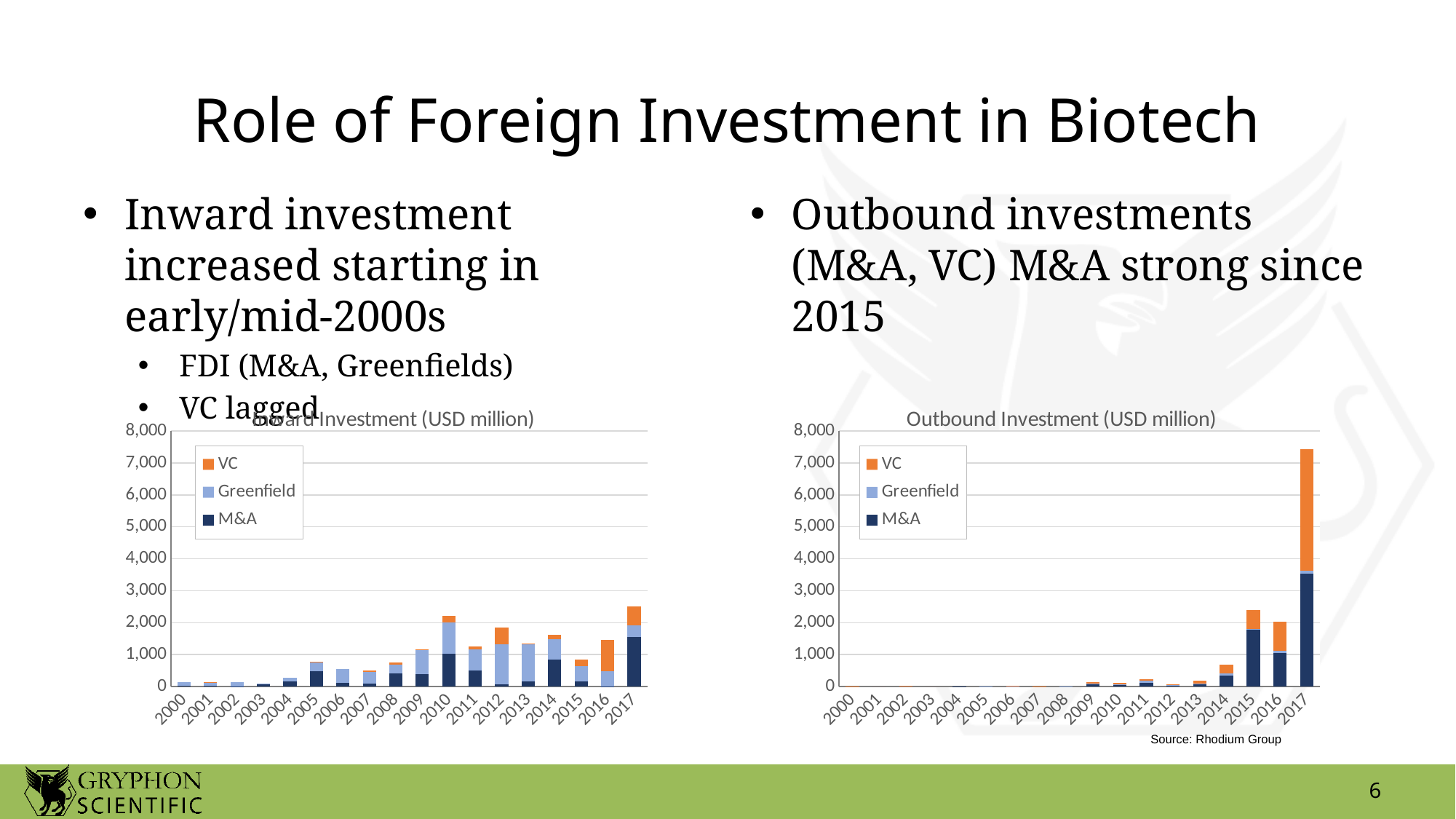
In the Inward Investment (USD million) chart, is the total value for 2005 greater or less than 1,000? less What kind of chart is the Inward Investment (USD million) chart? Stacked bar chart In the Inward Investment (USD million) chart, is the total value for 2017 greater or less than 2,000? greater In the Outbound Investment (USD million) chart, which year has the larger total bar, 2015 or 2017? 2017 In the Outbound Investment (USD million) chart, is the total value for 2015 greater or less than 2,000? greater How many series does the legend of the Outbound Investment (USD million) chart list? 3 In the Outbound Investment (USD million) chart, do the total values generally rise or fall from 2000 to 2017? Rise In the Inward Investment (USD million) chart, which year has the larger total bar, 2012 or 2013? 2012 In the Outbound Investment (USD million) chart, which year has the highest total bar? 2017 How many years are shown on the x axis of the Inward Investment (USD million) chart? 18 In the Inward Investment (USD million) chart, which series is shown in orange? VC